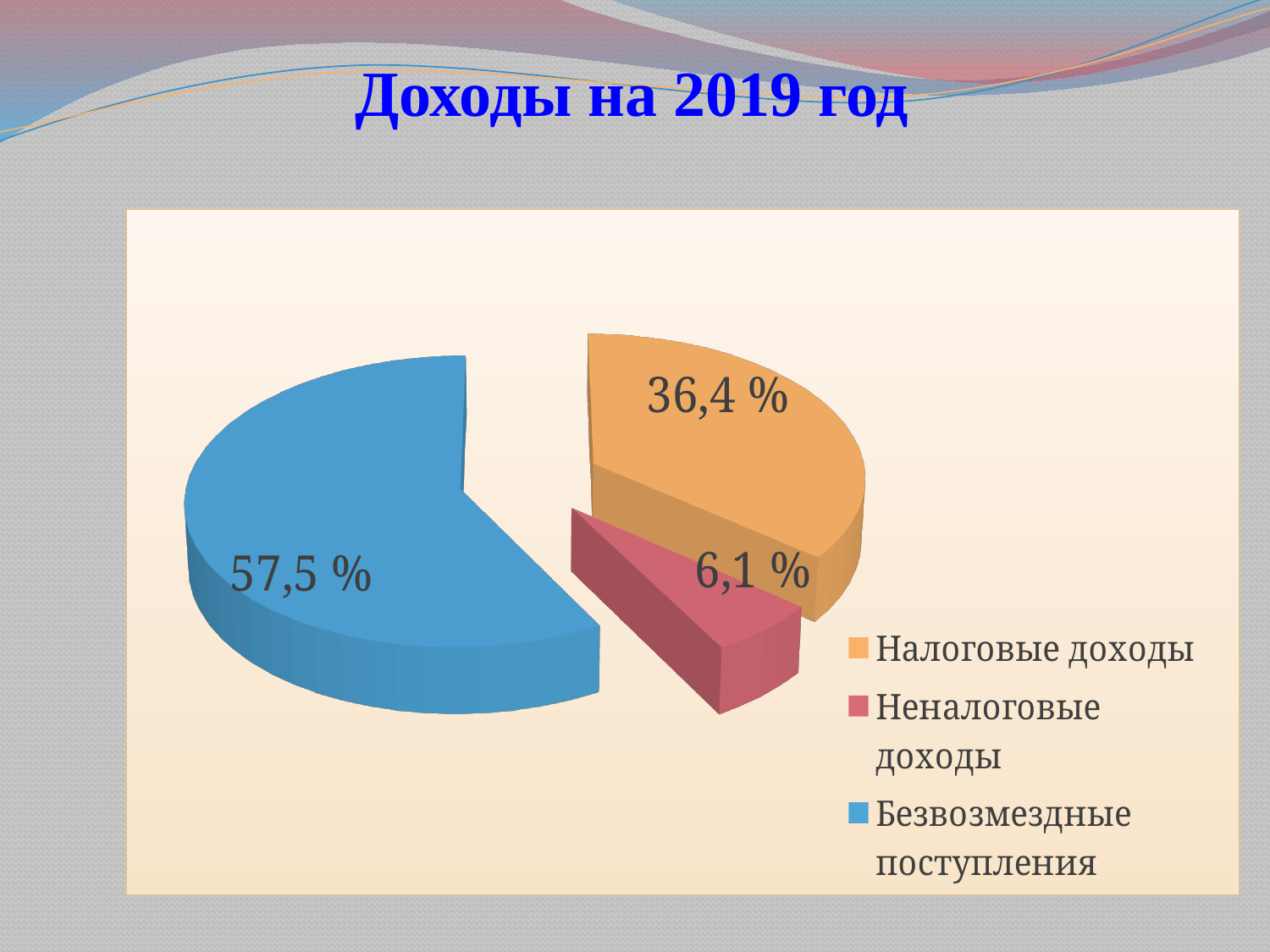
What colour is the slice for Безвозмездные поступления? Blue How many slices does the pie chart have? 3 Which category has the largest slice of the pie? Безвозмездные поступления What is the difference in percentage points between Безвозмездные поступления and Налоговые доходы? 21,1 What share of the pie is labelled for Безвозмездные поступления? 57,5 % Which is larger: the share for Налоговые доходы or the share for Неналоговые доходы? Налоговые доходы What share of the pie is labelled for Налоговые доходы? 36,4 % What is the difference in percentage points between Налоговые доходы and Неналоговые доходы? 30,3 What is the title of the slide containing the chart? Доходы на 2019 год What share of the pie is labelled for Неналоговые доходы? 6,1 % Which category has the smallest slice of the pie? Неналоговые доходы What kind of chart is shown on the slide? Pie chart